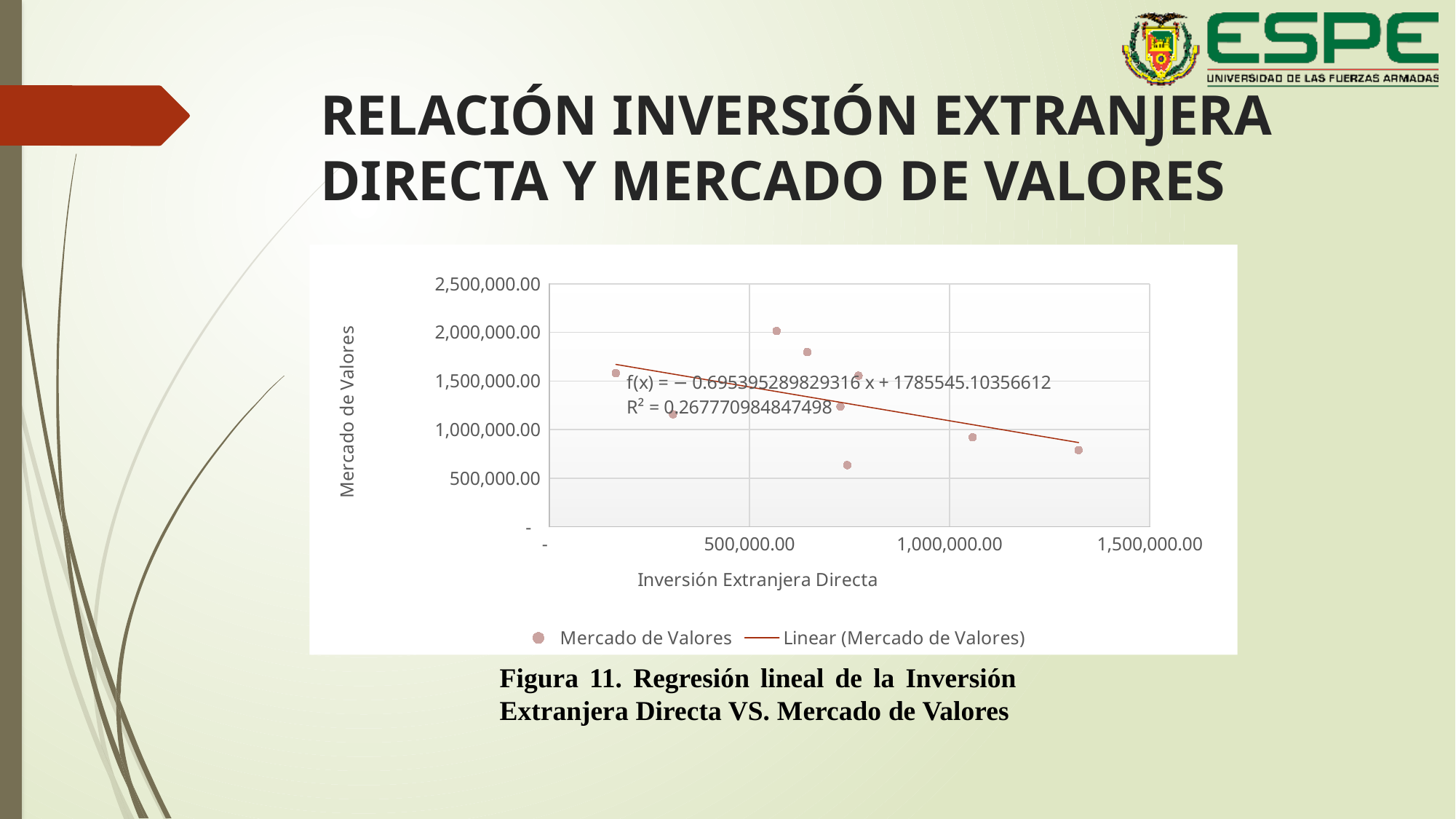
What is the R² value shown on the chart? 0.267770984847498 How many data points are plotted on the chart? 9 Is the lowest plotted Mercado de Valores value greater or less than 1,000,000.00? less What is the intercept of the linear trendline equation shown on the chart? 1785545.10356612 What kind of chart is shown on the slide? scatter chart What is the title of the vertical axis? Mercado de Valores What is the slope of the linear trendline equation shown on the chart? −0.695395289829316 What is the title of the horizontal axis? Inversión Extranjera Directa Does the linear trendline rise or fall as Inversión Extranjera Directa increases? fall Is the Inversión Extranjera Directa value of the rightmost data point greater or less than 1,000,000.00? greater How many entries does the legend list? 2